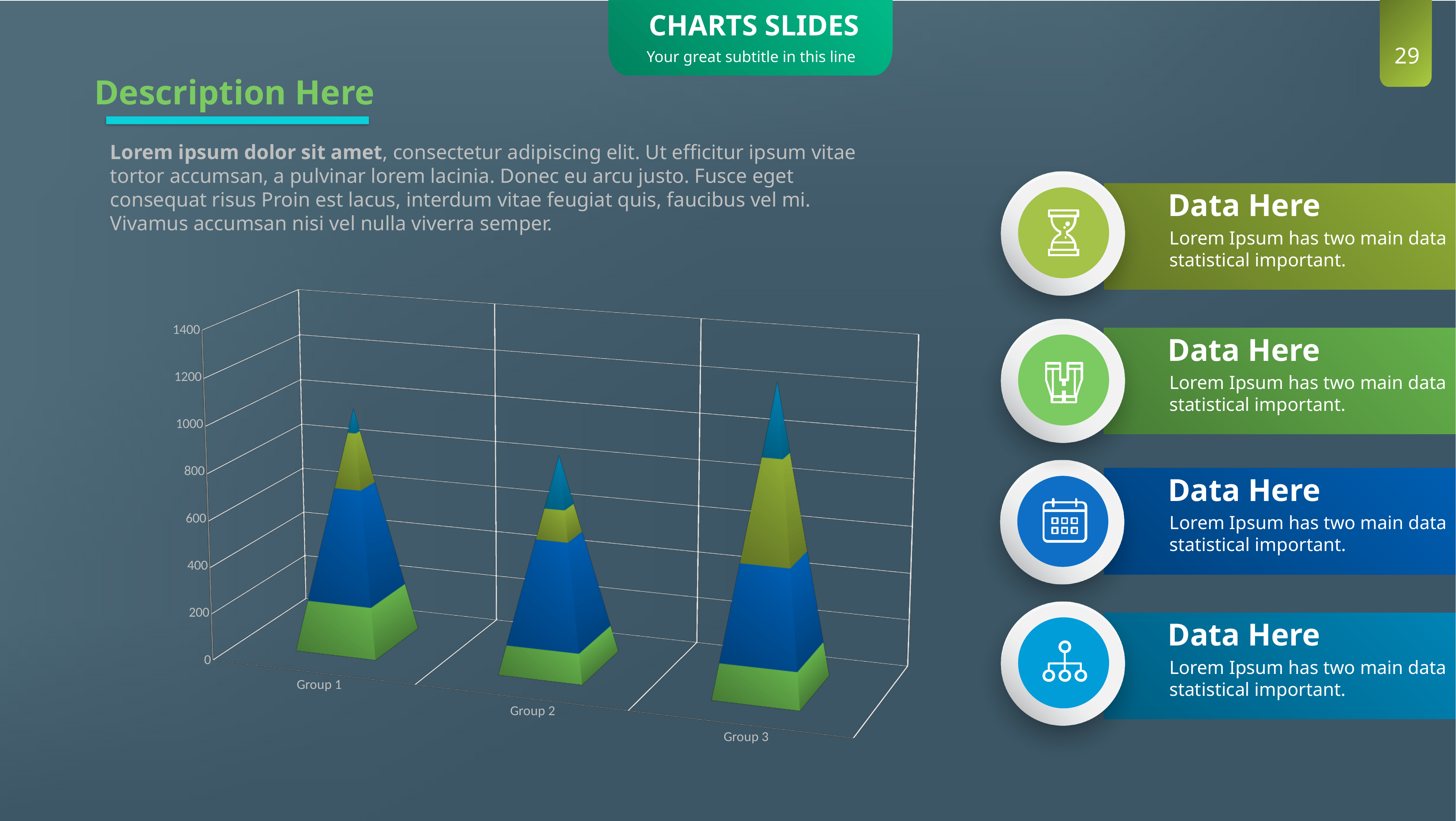
Is the total height of the bar for Group 1 greater or less than 600? greater Which group has the shortest stacked bar in the chart? Group 2 Which is taller in the chart, the bar for Group 1 or the bar for Group 2? Group 1 What kind of chart is shown on the slide? bar chart What is the highest value shown on the chart's vertical axis? 1400 Does the bar height rise or fall from Group 1 to Group 2? fall How many groups (categories) are shown on the x axis of the chart? 3 Which group has the tallest stacked bar in the chart? Group 3 Is the total height of the bar for Group 3 greater or less than 800? greater Which is taller in the chart, the bar for Group 2 or the bar for Group 3? Group 3 Is the total height of the bar for Group 2 greater or less than 1200? less How many coloured segments make up each stacked bar in the chart? 4